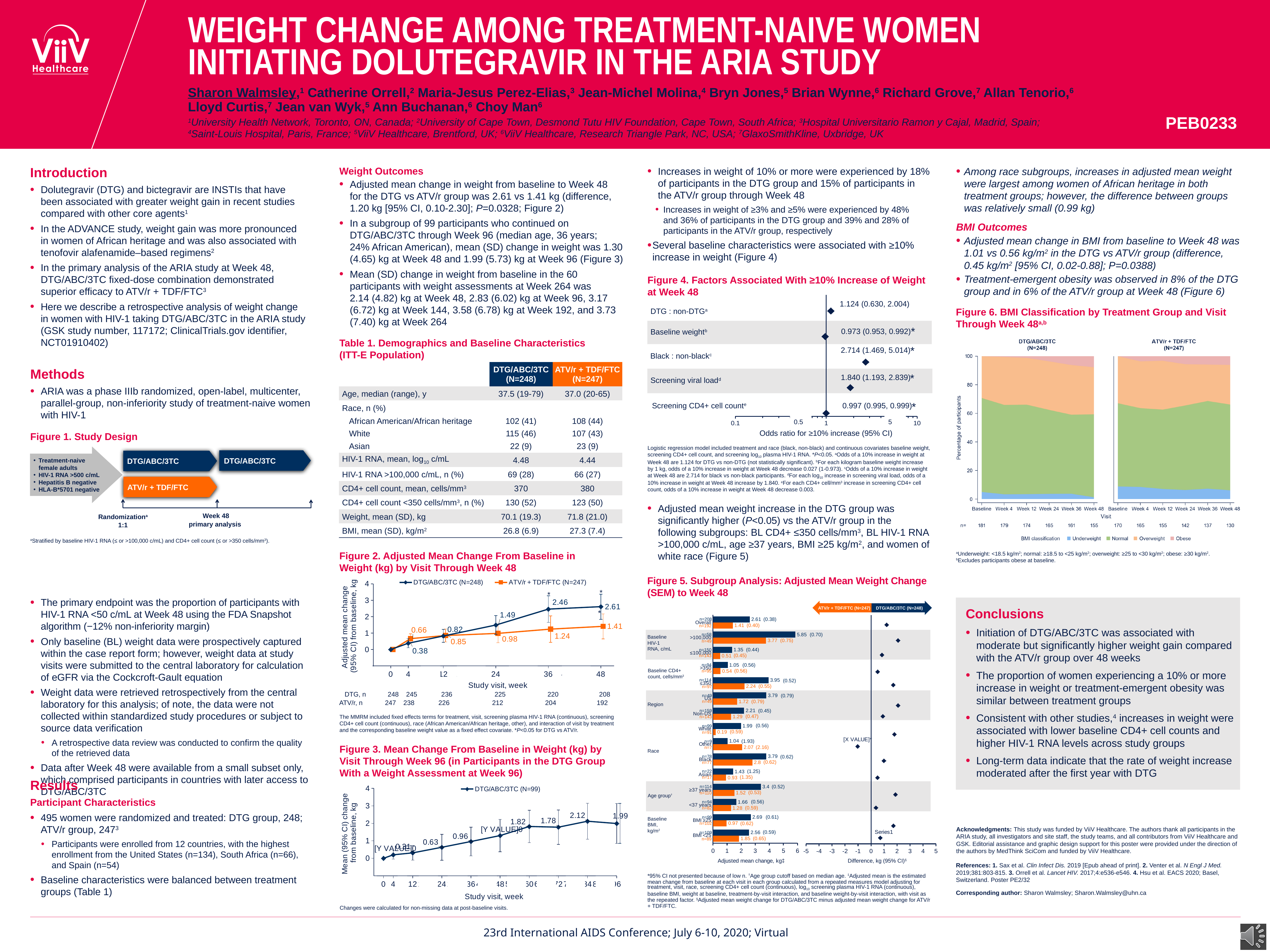
In Figure 2, what is the difference between the DTG/ABC/3TC and ATV/r + TDF/FTC values at Week 48? 1.20 How many BMI classification categories does the legend of Figure 6 list? 4 In Figure 2, does the DTG/ABC/3TC line rise or fall from Week 0 to Week 48? Rise In Figure 3, what is the mean change from baseline in weight at Week 96? 1.99 In Figure 4, which factor has the highest odds ratio for a ≥10% increase in weight? Black : non-black In Figure 2, what is the adjusted mean change in weight for ATV/r + TDF/FTC at Week 24? 0.98 In Figure 4, what is the odds ratio (95% CI) for screening viral load? 1.840 (1.193, 2.839) What kind of chart is Figure 2? Line chart How many series does the legend of Figure 2 list? 2 In Figure 2, which group has the larger value at Week 4, DTG/ABC/3TC or ATV/r + TDF/FTC? ATV/r + TDF/FTC In Figure 2, what is the adjusted mean change in weight for DTG/ABC/3TC at Week 48? 2.61 In Figure 5, what is the overall adjusted mean weight change (SEM) for the DTG/ABC/3TC group? 2.61 (0.38)